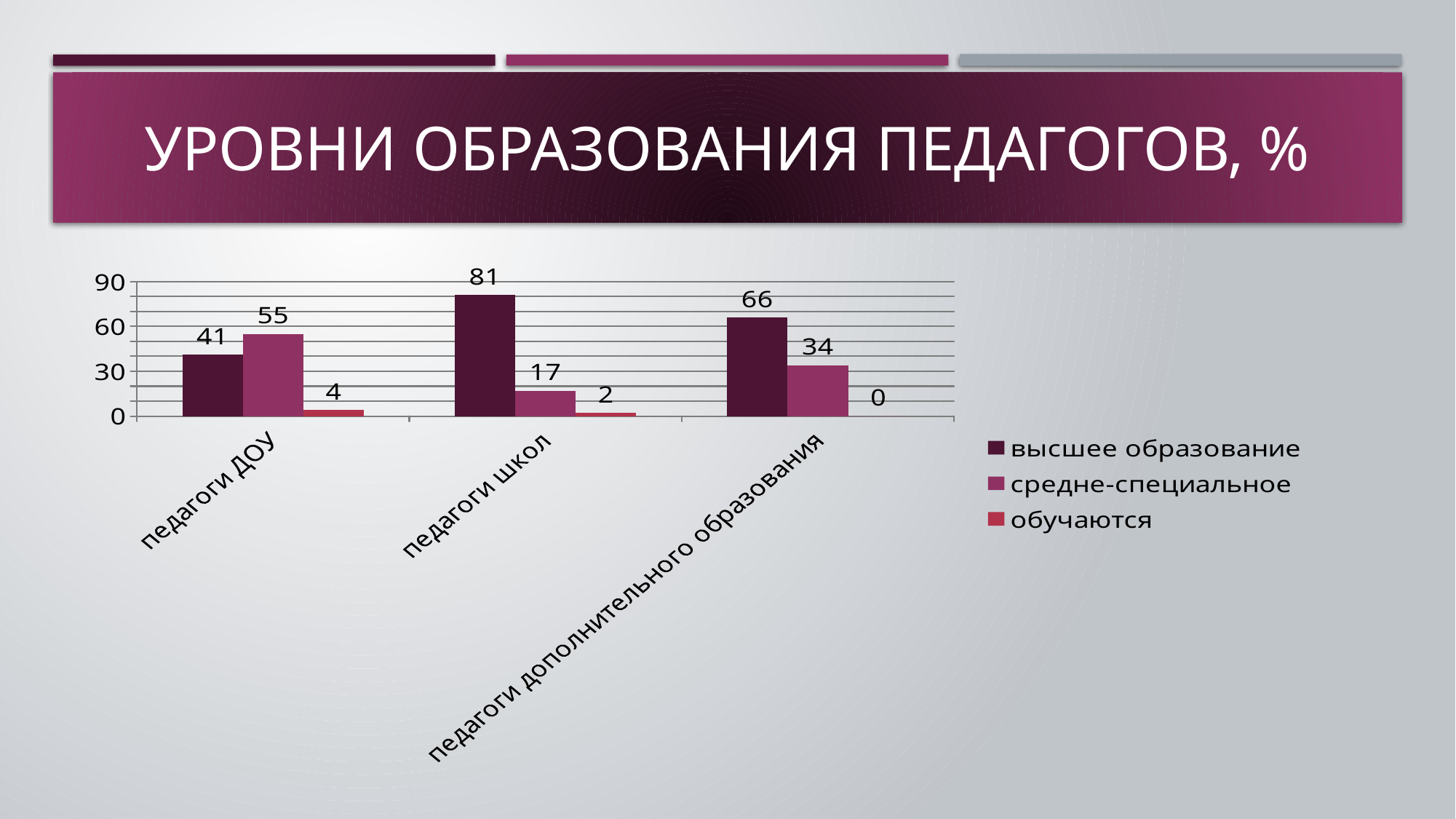
What is the value for обучаются among педагоги дополнительного образования? 0 Which category has the lowest value for средне-специальное? педагоги школ Which is larger for педагоги ДОУ: высшее образование or средне-специальное? средне-специальное What is the difference between высшее образование and средне-специальное for педагоги дополнительного образования? 32 Is the value for высшее образование among педагоги дополнительного образования greater or less than 60? greater What is the value for средне-специальное among педагоги ДОУ? 55 Which category has the highest value for высшее образование? педагоги школ How many categories are shown on the x axis? 3 What is the value for высшее образование among педагоги школ? 81 What kind of chart is shown on the slide? bar chart What is the title of the slide? УРОВНИ ОБРАЗОВАНИЯ ПЕДАГОГОВ, % How many series does the legend list? 3